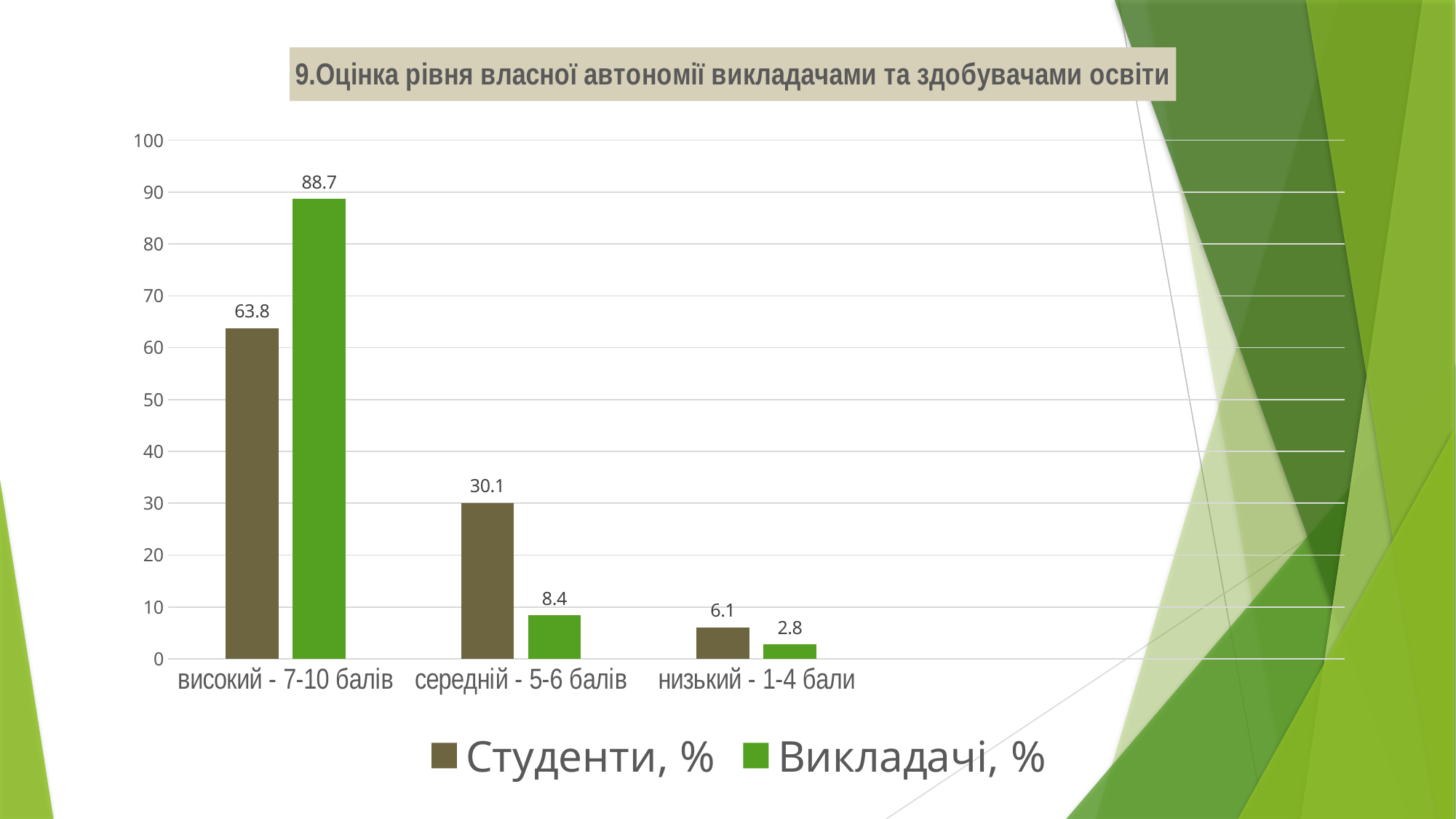
What kind of chart is shown on the slide? bar chart Which category has the lowest value for Студенти, %? низький - 1-4 бали How many series does the legend list? 2 Which category has the highest value for Викладачі, %? високий - 7-10 балів What is the difference between Викладачі, % and Студенти, % in the category високий - 7-10 балів? 24.9 In the category середній - 5-6 балів, which series has the larger value, Студенти, % or Викладачі, %? Студенти, % What is the value for Викладачі, % in the category низький - 1-4 бали? 2.8 Is the value for Викладачі, % in the category середній - 5-6 балів greater or less than 10? less How many categories are shown on the x axis? 3 What is the value for Студенти, % in the category високий - 7-10 балів? 63.8 What is the value for Викладачі, % in the category високий - 7-10 балів? 88.7 What is the value for Студенти, % in the category середній - 5-6 балів? 30.1